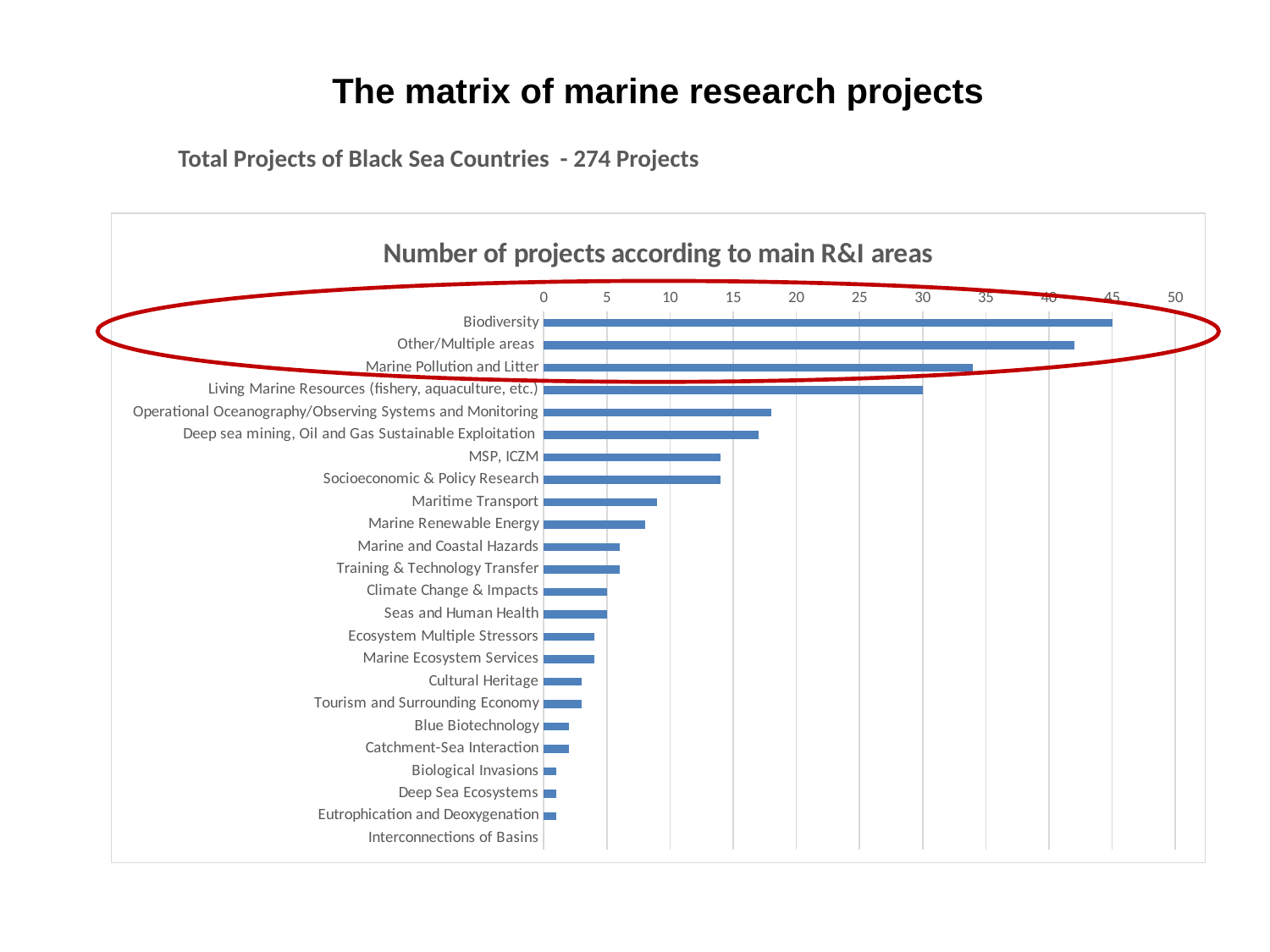
Which has more projects, Marine Renewable Energy or Cultural Heritage? Marine Renewable Energy What type of chart is shown on the slide? bar chart What is the title of the chart? Number of projects according to main R&I areas Is the value for Operational Oceanography/Observing Systems and Monitoring greater or less than 20? less Which has more projects, Other/Multiple areas or Marine Pollution and Litter? Other/Multiple areas Is the value for Maritime Transport greater or less than 10? less Which R&I area has the highest number of projects? Biodiversity How many R&I areas (categories) are listed on the chart? 24 What is the highest value shown on the horizontal axis of the chart? 50 Is the value for Marine Pollution and Litter greater or less than 30? greater Which R&I area has the lowest number of projects? Interconnections of Basins